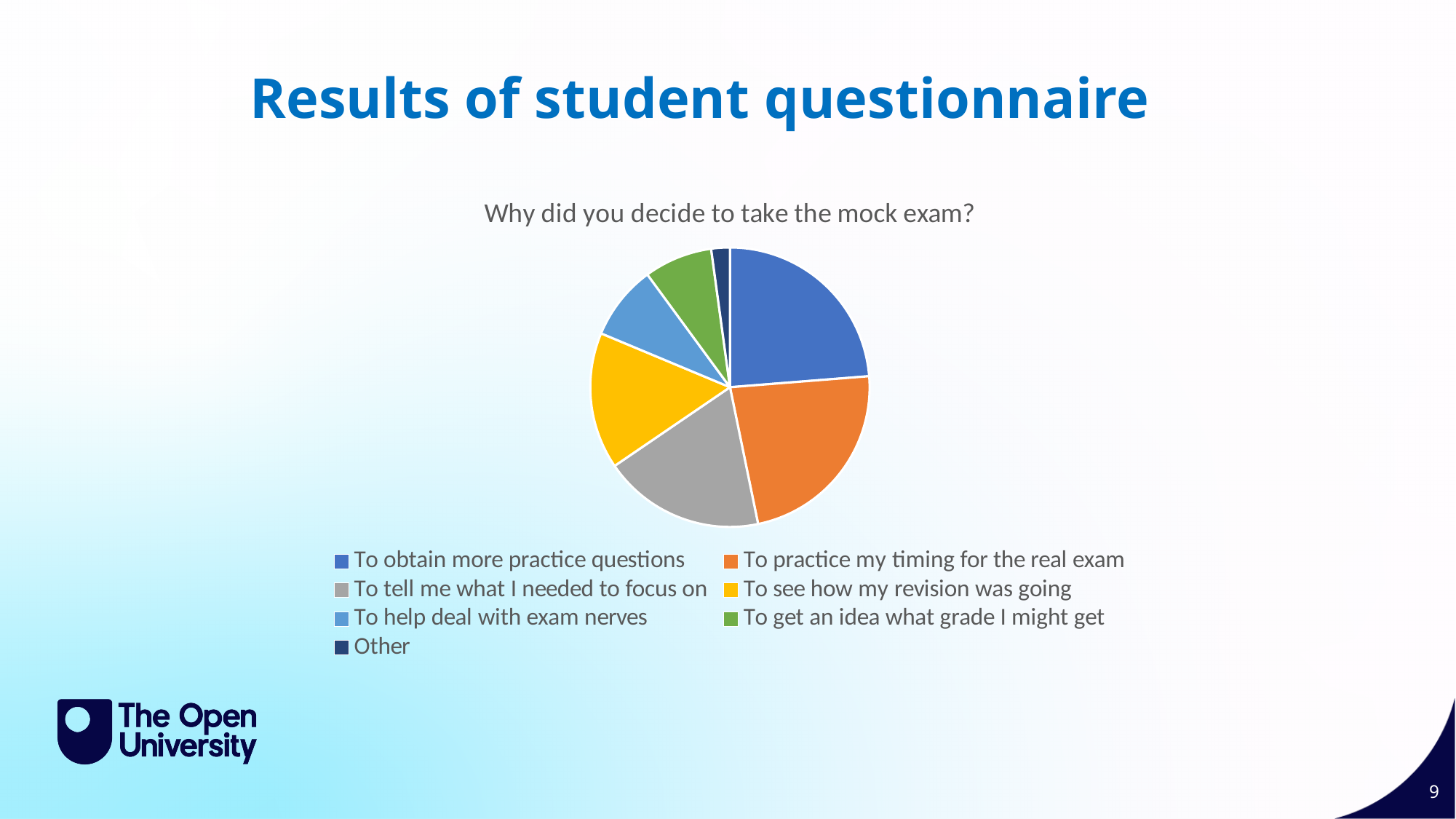
Which category is shown in orange in the pie chart? To practice my timing for the real exam Which slice is larger: "To practice my timing for the real exam" or "To see how my revision was going"? To practice my timing for the real exam What kind of chart is shown on the slide? pie chart Which category has the smallest slice of the pie? Other Which slice is larger: "To tell me what I needed to focus on" or "To help deal with exam nerves"? To tell me what I needed to focus on How many categories (slices) does the pie chart have? 7 What is the title of the chart? Why did you decide to take the mock exam? Which slice is larger: "To obtain more practice questions" or "To get an idea what grade I might get"? To obtain more practice questions